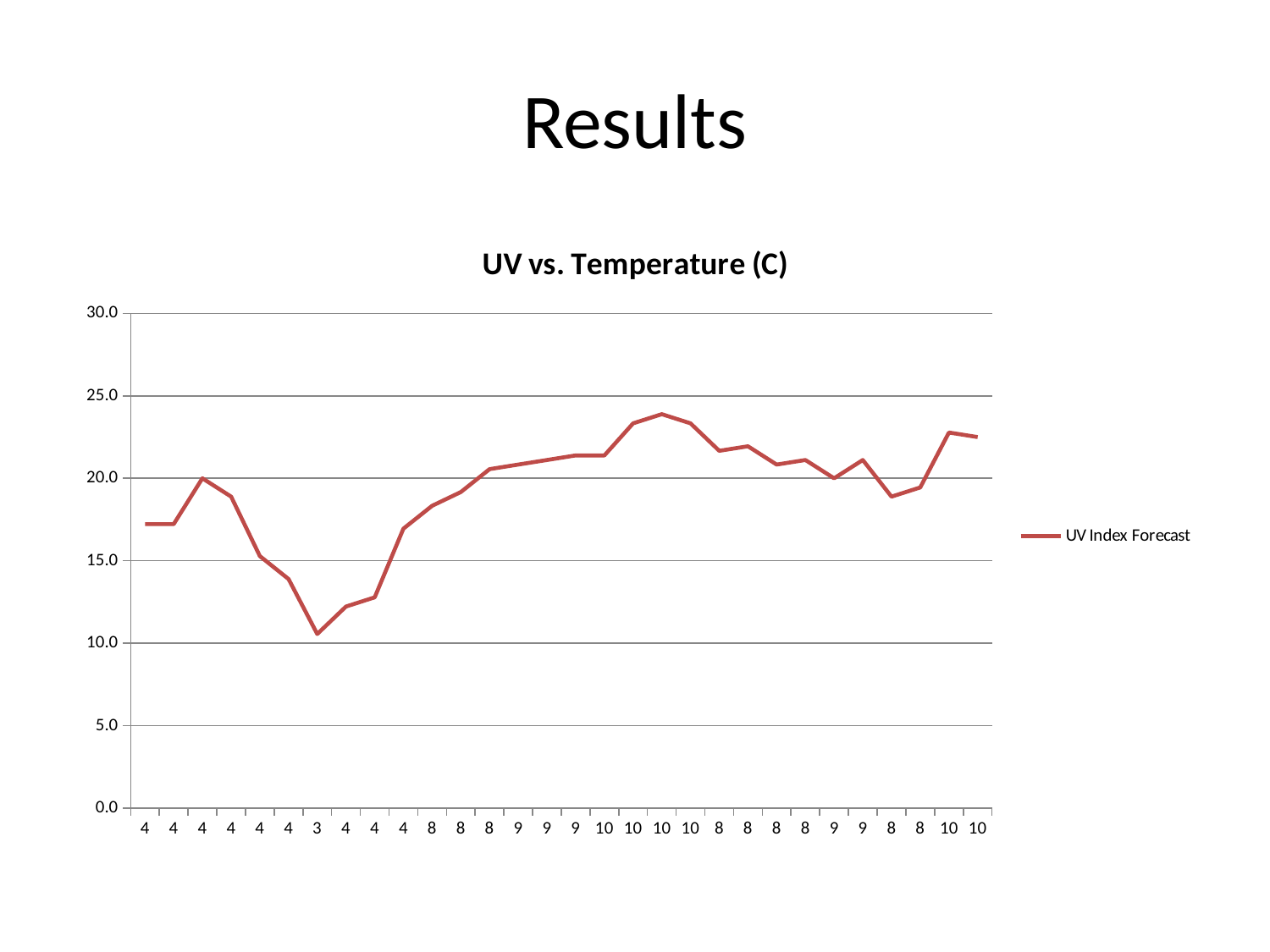
What is the name of the series shown in the legend? UV Index Forecast Is the value at the point labelled 3 on the x axis greater or less than 15.0? less What kind of chart is shown on the slide? line chart Is the highest value on the line greater or less than 20.0? greater Is the value of the first point on the line greater or less than 15.0? greater From the lowest point (labelled 3) to the first point labelled 10, does the line rise or fall? rise How many data points are plotted on the line? 30 How many series does the legend list? 1 Which x-axis label corresponds to the lowest point on the line? 3 What is the title of the chart? UV vs. Temperature (C)